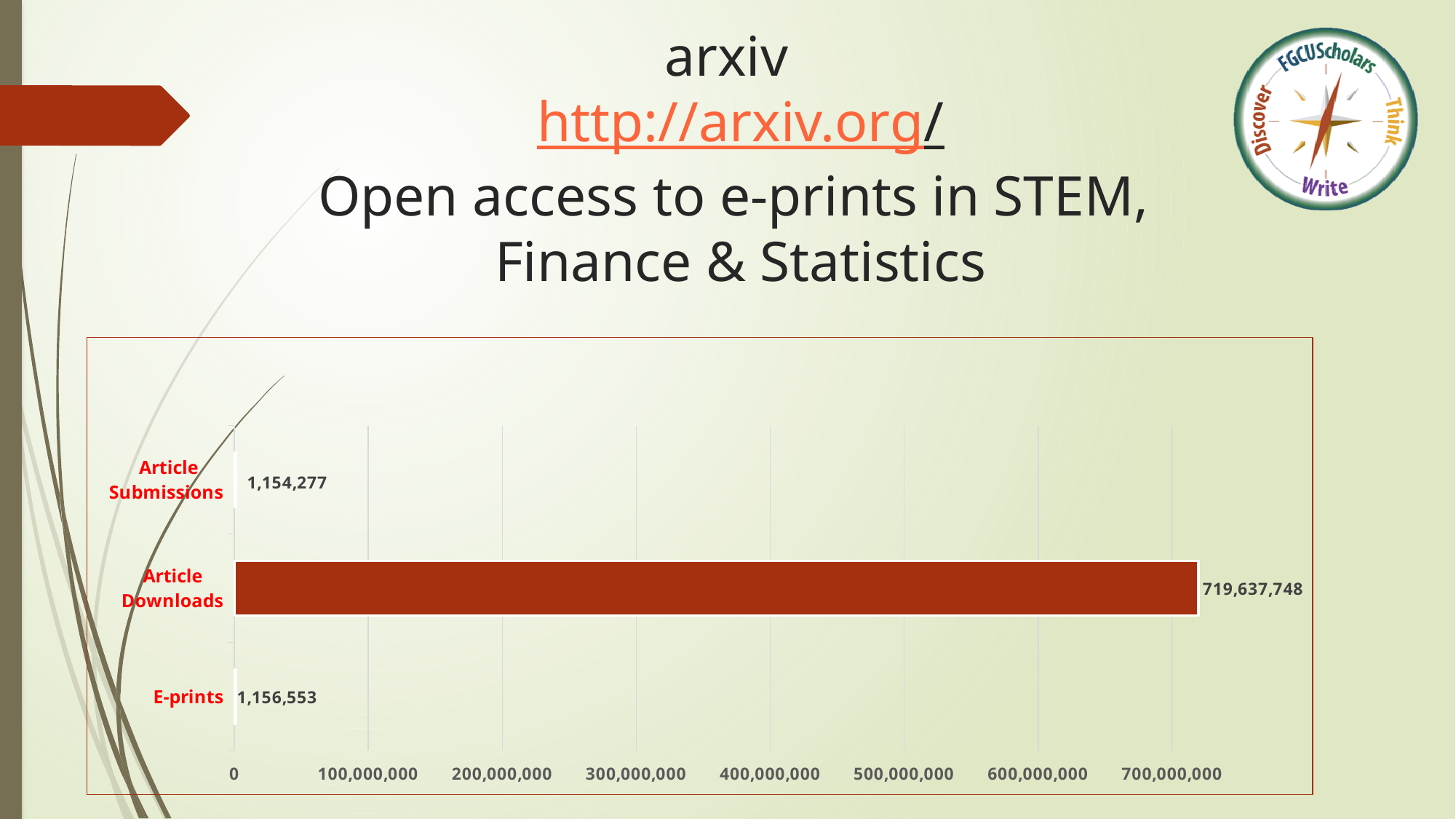
Which is larger, the value for E-prints or the value for Article Submissions? E-prints What is the difference between the value for E-prints and the value for Article Submissions? 2,276 What is the value for E-prints? 1,156,553 Which category has the highest value? Article Downloads Is the value for Article Downloads greater or less than 700,000,000? greater What is the largest value labelled on the horizontal axis? 700,000,000 What is the value for Article Submissions? 1,154,277 How many categories are shown in the chart? 3 What is the value for Article Downloads? 719,637,748 Is the value for Article Submissions greater or less than 100,000,000? less What is the difference between the value for Article Downloads and the value for Article Submissions? 718,483,471 What kind of chart is shown on the slide? bar chart